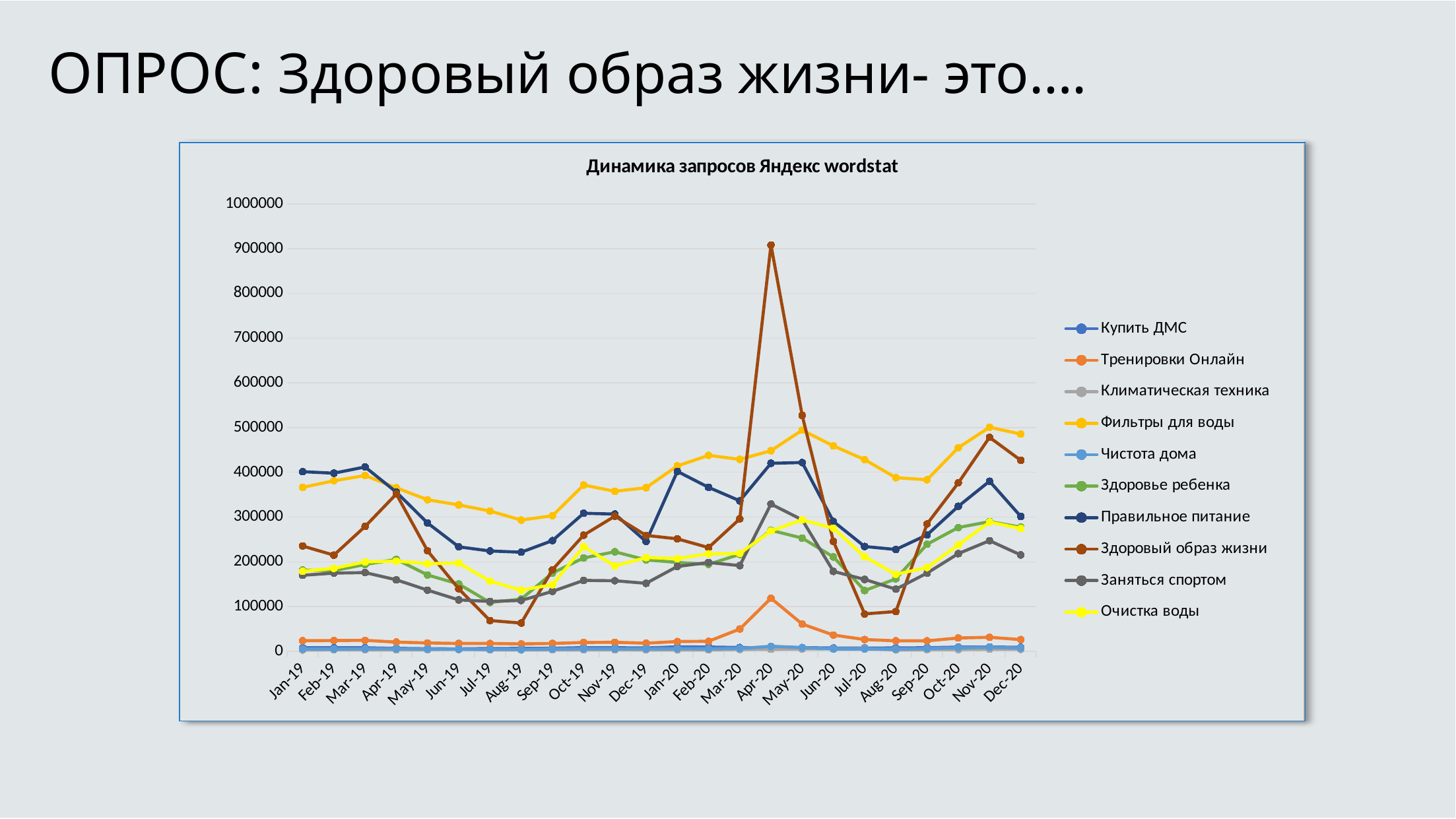
What kind of chart is shown on the slide? line chart Which series is higher in Jan-20: Правильное питание or Заняться спортом? Правильное питание In which month does the series Здоровый образ жизни reach its highest value? Apr-20 Does the series Здоровый образ жизни rise or fall from Apr-20 to Jul-20? fall Is the value for Здоровый образ жизни in Jul-19 greater or less than 100000? less Which series is higher in Apr-20: Тренировки Онлайн or Фильтры для воды? Фильтры для воды How many series does the legend list? 10 What is the title of the chart? Динамика запросов Яндекс wordstat How many months are shown along the x axis? 24 Is the value for Здоровый образ жизни in Apr-20 greater or less than 800000? greater Is the value for Фильтры для воды in Nov-20 greater or less than 400000? greater Which series is shown in yellow in the legend? Очистка воды